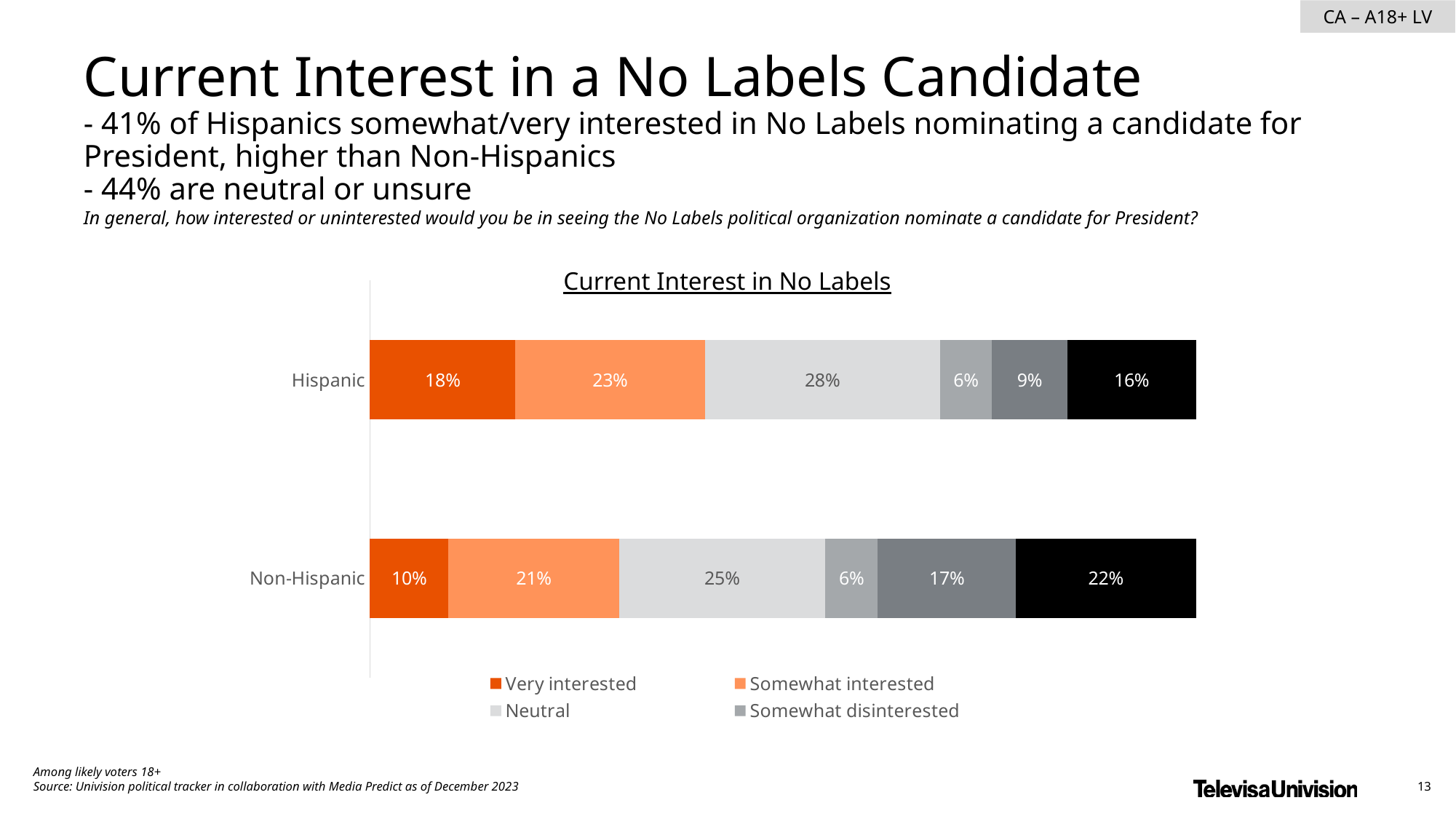
What is the Neutral value for Hispanic respondents? 28% Which group has the higher Very interested share, Hispanic or Non-Hispanic? Hispanic How many series does the legend list? 4 What is the difference between the Neutral values for Hispanic and Non-Hispanic respondents? 3% What percentage of Non-Hispanic respondents are somewhat interested? 21% How many groups (bars) are shown in the chart? 2 What is the difference between the Very interested values for Hispanic and Non-Hispanic respondents? 8% Which legend category is the largest segment in the Hispanic bar? Neutral What percentage of Hispanic respondents are very interested? 18% What is the Somewhat disinterested value for Non-Hispanic respondents? 6% What is the combined share of Very interested and Somewhat interested among Hispanic respondents? 41% What type of chart is shown on the slide? Stacked bar chart